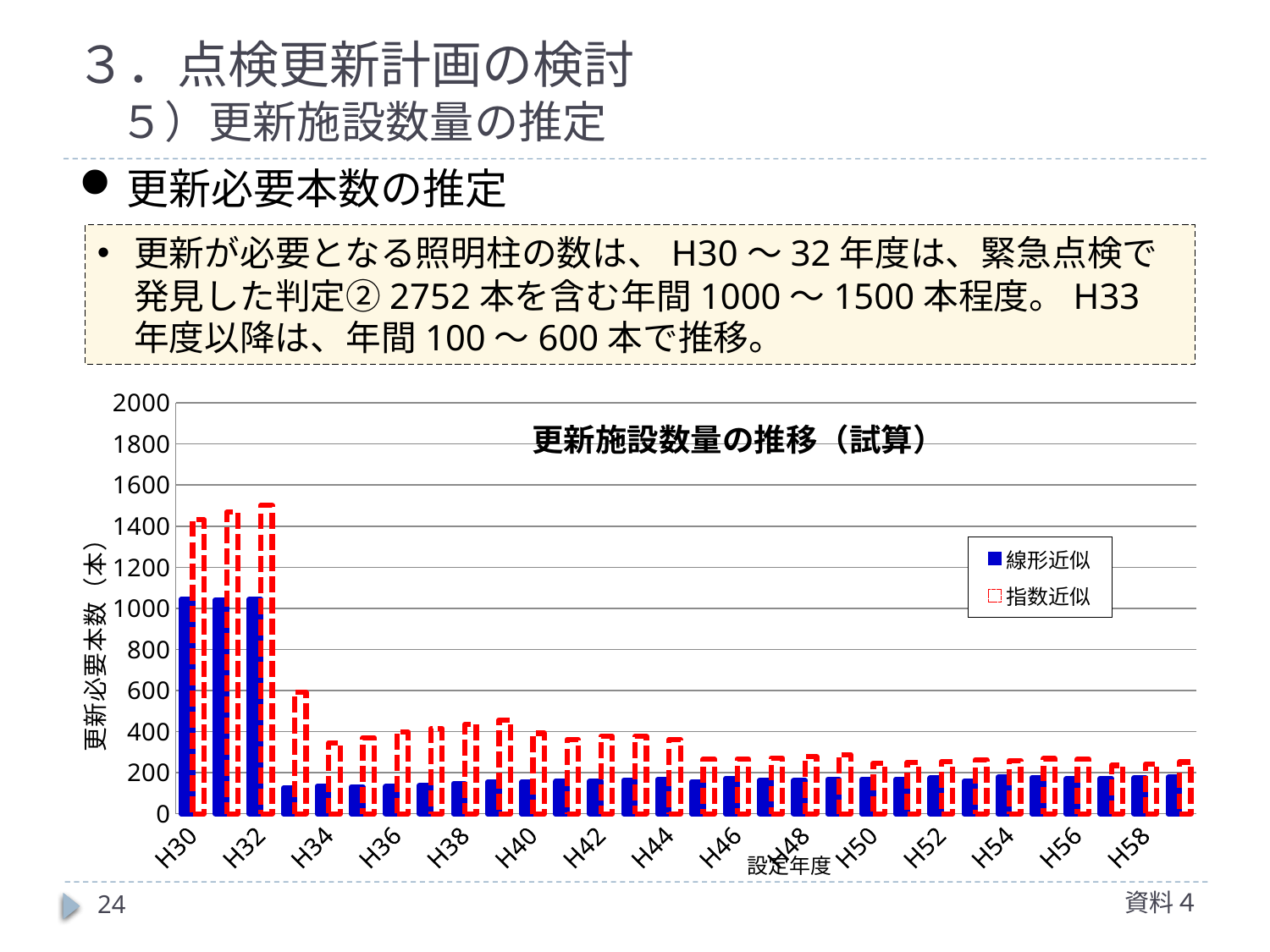
At H36, which series has the larger value, 線形近似 or 指数近似? 指数近似 At H30, which series has the larger value, 線形近似 or 指数近似? 指数近似 How many series does the chart legend list? 2 Is the 線形近似 value for H34 greater or less than 200? less Which series is drawn with solid blue bars in the chart? 線形近似 Is the 指数近似 value for H32 greater or less than 1200? greater Is the 線形近似 value for H30 greater or less than 1000? greater What kind of chart is shown on the slide? bar chart What is the title of the chart? 更新施設数量の推移（試算）